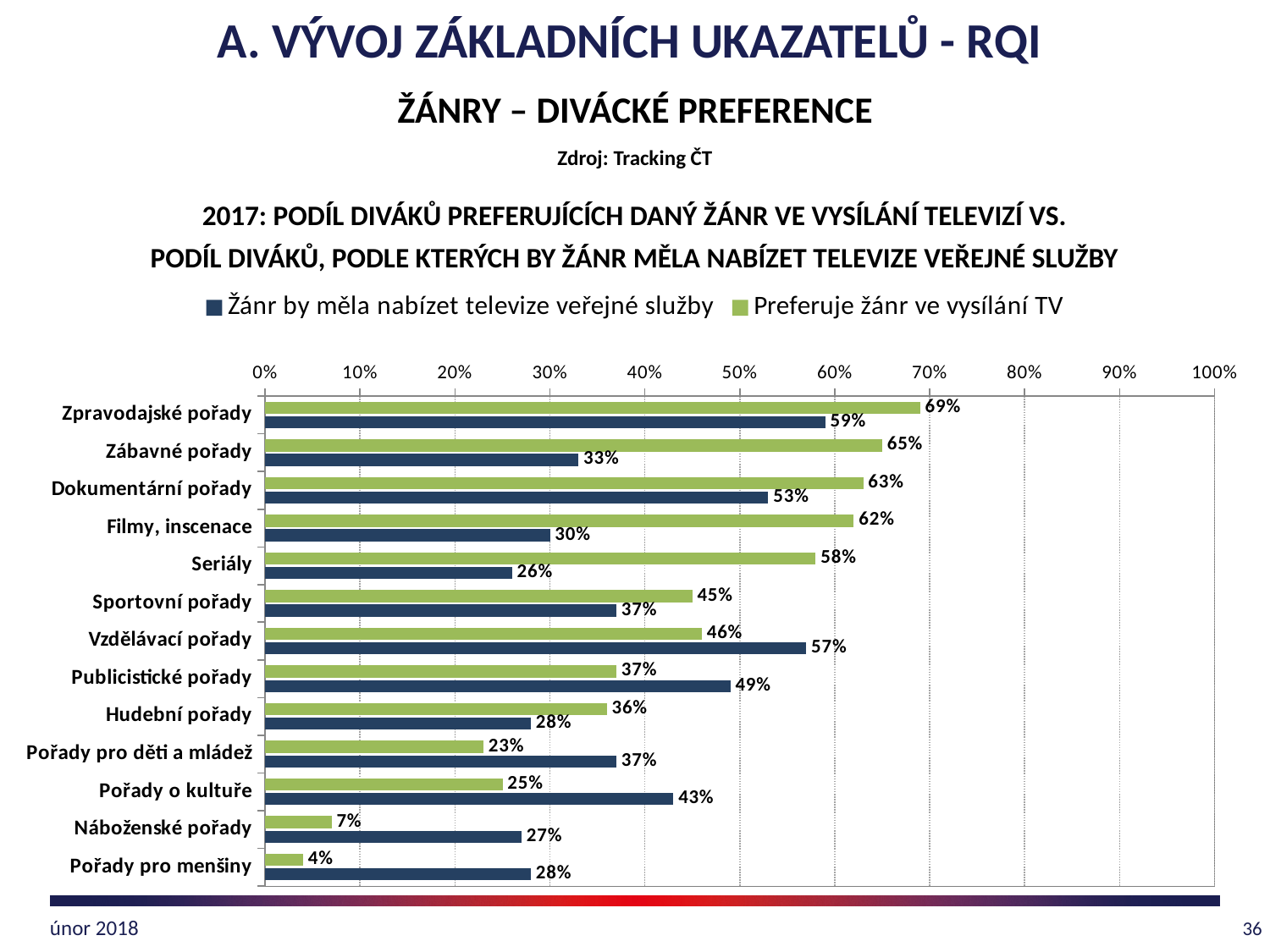
How many series does the legend list? 2 Which category has the highest value in the 'Preferuje žánr ve vysílání TV' series? Zpravodajské pořady How many categories are shown on the chart? 13 What is the value for Pořady pro menšiny in the 'Preferuje žánr ve vysílání TV' series? 4% Which category has the lowest value in the 'Žánr by měla nabízet televize veřejné služby' series? Seriály What is the value for Zpravodajské pořady in the 'Preferuje žánr ve vysílání TV' series? 69% What colour are the bars for the 'Preferuje žánr ve vysílání TV' series? Green What kind of chart is shown on the slide? Bar chart What is the difference between the two series values for Zábavné pořady? 32% What is the value for Vzdělávací pořady in the 'Žánr by měla nabízet televize veřejné služby' series? 57% For Pořady o kultuře, which series has the larger value? Žánr by měla nabízet televize veřejné služby What is the total of the two series values for Náboženské pořady? 34%